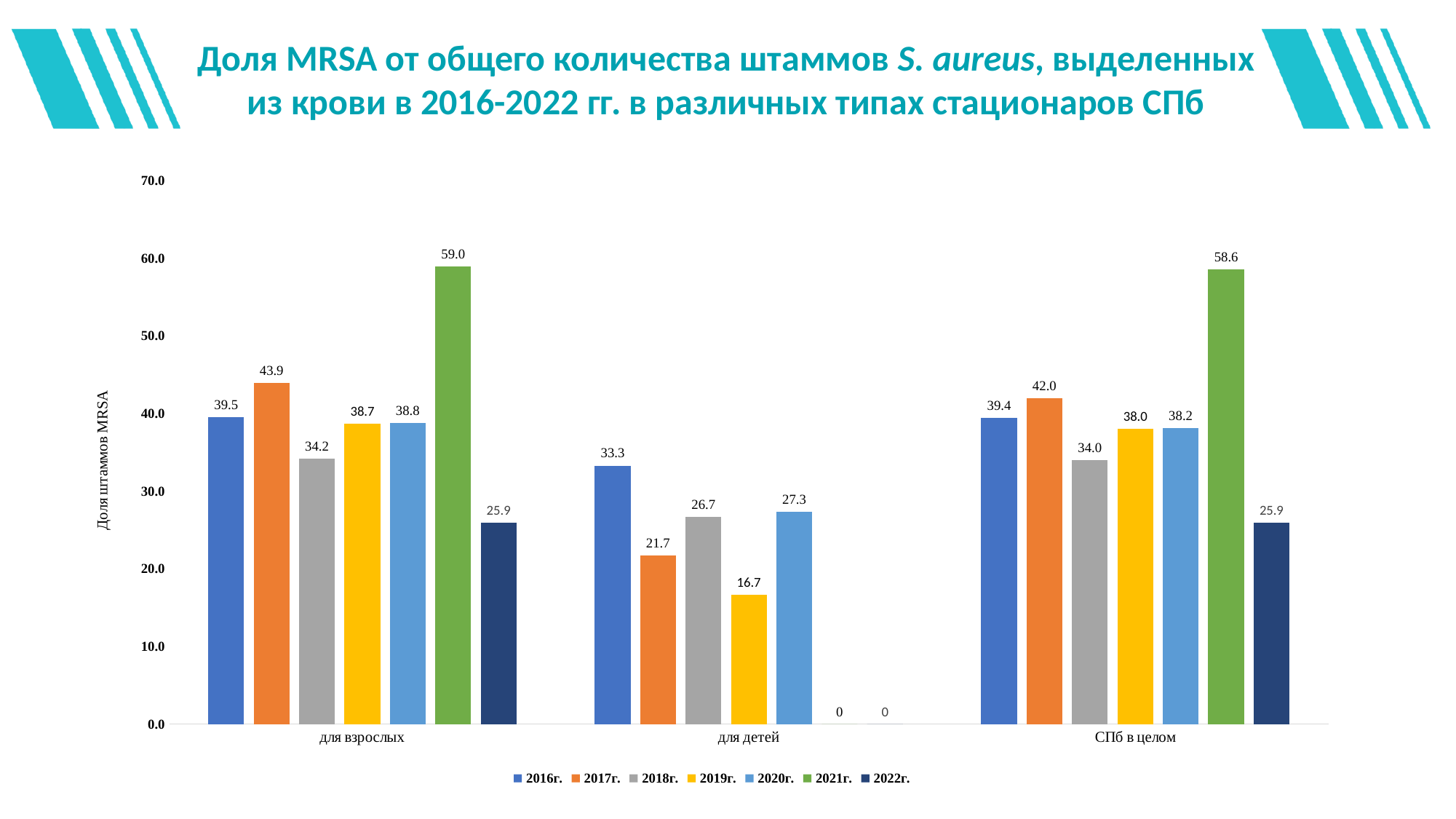
Which year has the highest value in the "СПб в целом" group? 2021г. Which is larger: the 2017г. value for "для взрослых" or the 2017г. value for "для детей"? для взрослых What is the difference between the 2021г. and 2022г. values in the "для взрослых" group? 33.1 Which year has the lowest non-zero value in the "для детей" group? 2019г. What is the value for 2019г. in the "для детей" group? 16.7 How many hospital-type categories are shown on the x axis? 3 What is the value for 2017г. in the "СПб в целом" group? 42.0 What is the value for 2021г. in the "для детей" group? 0 What kind of chart is shown on the slide? bar chart How many series does the legend list? 7 What is the value for 2021г. in the "для взрослых" group? 59.0 What is the label of the vertical axis? Доля штаммов MRSA